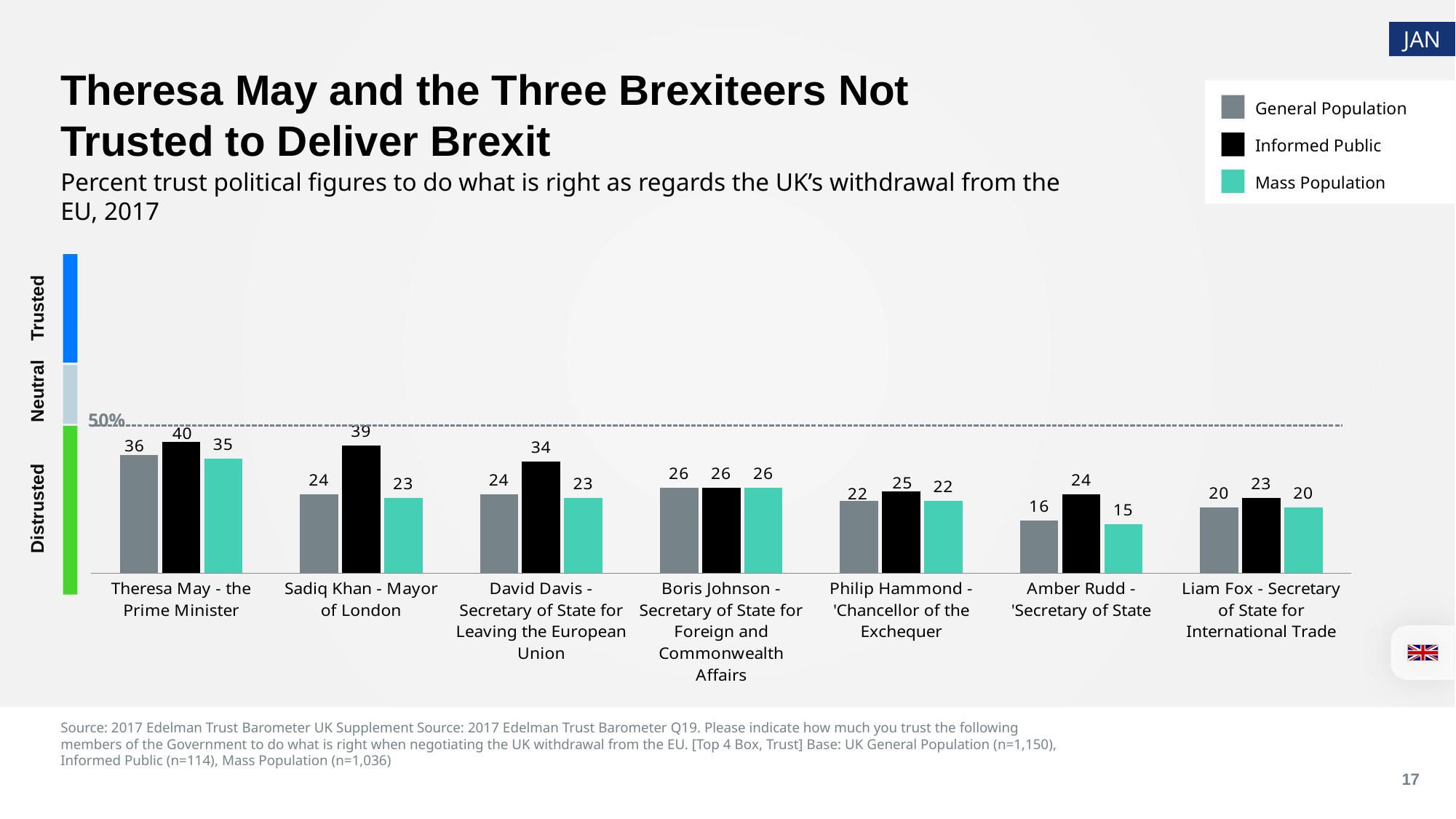
Which is larger for Philip Hammond - 'Chancellor of the Exchequer: the Informed Public value or the General Population value? Informed Public What is the Mass Population value for Amber Rudd - 'Secretary of State? 15 Is the Informed Public value for Theresa May - the Prime Minister greater or less than 50%? less What is the Informed Public value for Theresa May - the Prime Minister? 40 What is the difference between the Informed Public and Mass Population values for David Davis - Secretary of State for Leaving the European Union? 11 Which political figure has the lowest General Population value? Amber Rudd - 'Secretary of State How many political figures are shown on the x axis? 7 Which political figure has the highest Informed Public value? Theresa May - the Prime Minister Which colour represents Mass Population in the legend? teal How many series does the legend list? 3 What is the General Population value for Sadiq Khan - Mayor of London? 24 What kind of chart is shown on the slide? bar chart